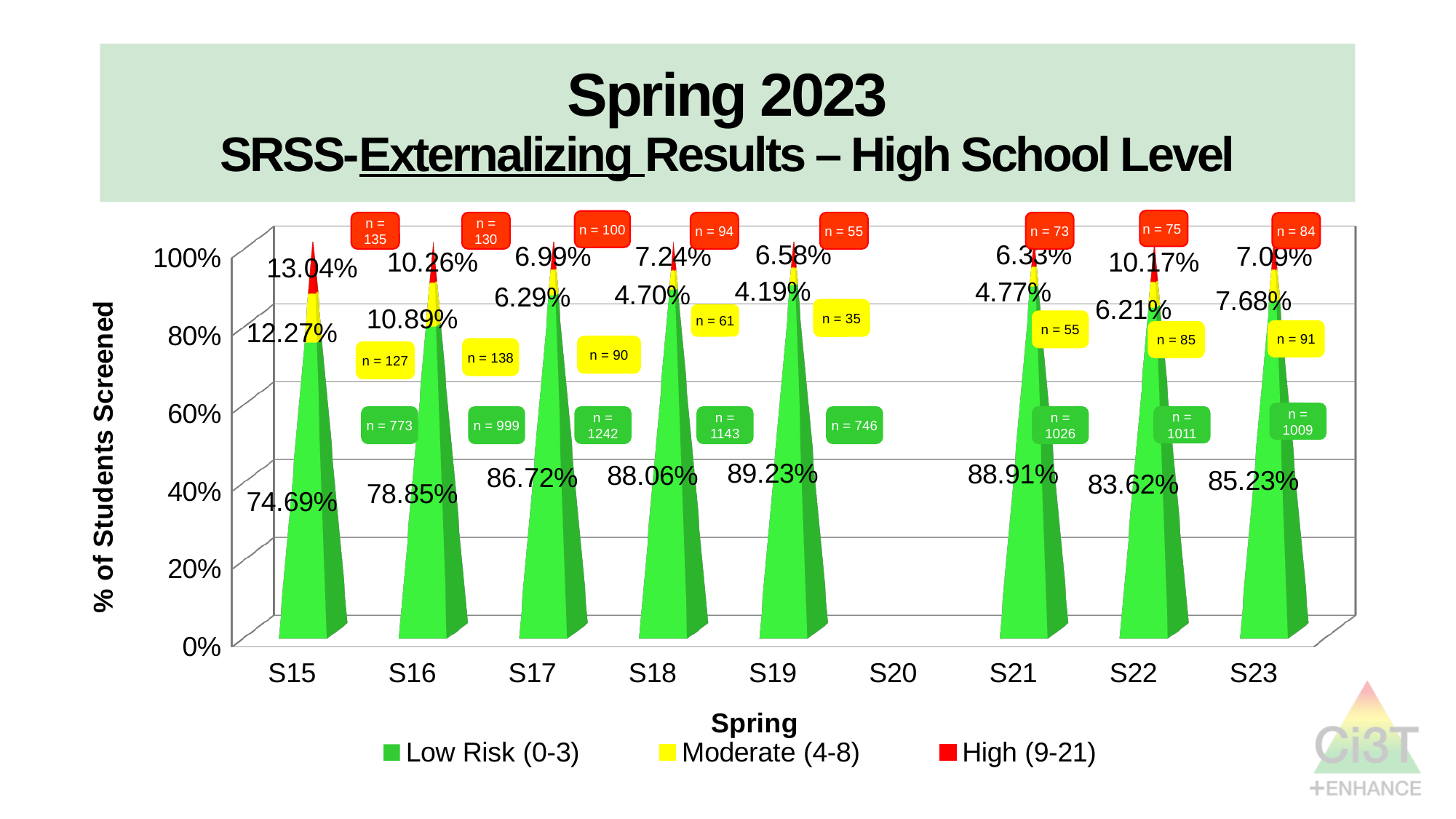
What is the High (9-21) percentage for S22? 10.17% What is the difference between the Low Risk percentages for S19 and S15? 14.54% What is the Moderate (4-8) percentage for S19? 4.19% What kind of chart is shown on the slide? bar chart Which spring has the lowest Low Risk (0-3) percentage? S15 Which is larger, the High (9-21) percentage for S15 or for S16? S15 Does the Low Risk (0-3) percentage rise or fall from S15 to S19? rise How many series does the legend list? 3 Which spring has the highest Low Risk (0-3) percentage? S19 How many spring labels are shown on the x axis? 9 What is the n value shown for the Low Risk group in S17? n = 1242 What is the Low Risk (0-3) percentage for S15? 74.69%